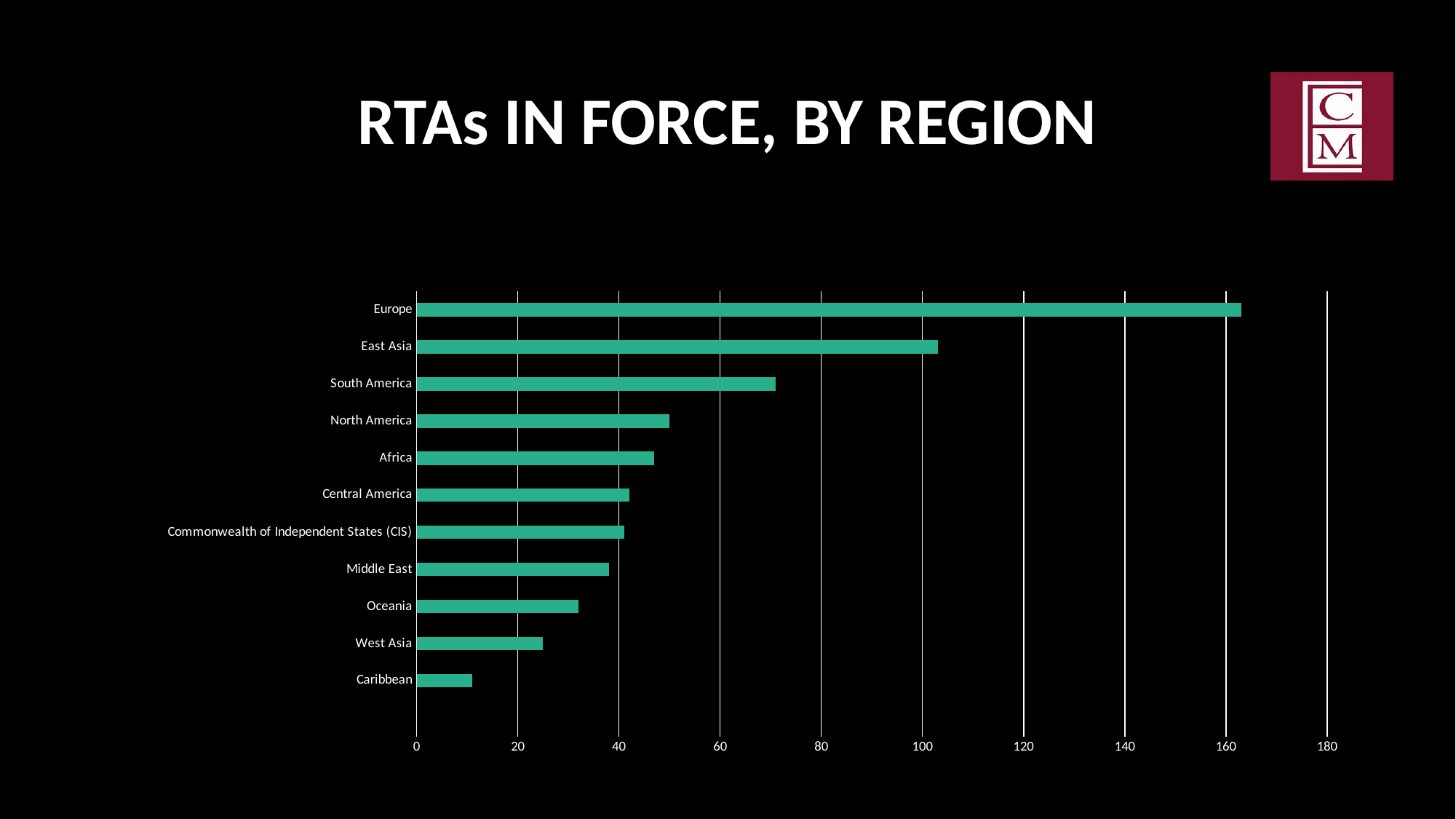
Which has more RTAs in force, West Asia or Caribbean? West Asia What is the title of the chart? RTAs IN FORCE, BY REGION Which region has the lowest number of RTAs in force? Caribbean Is the value for Europe greater or less than 140? greater Is the value for Oceania greater or less than 40? less Which has more RTAs in force, South America or North America? South America What kind of chart is shown on the slide? Bar chart How many regions are plotted in the chart? 11 Is the value for Caribbean greater or less than 20? less Which region has the highest number of RTAs in force? Europe